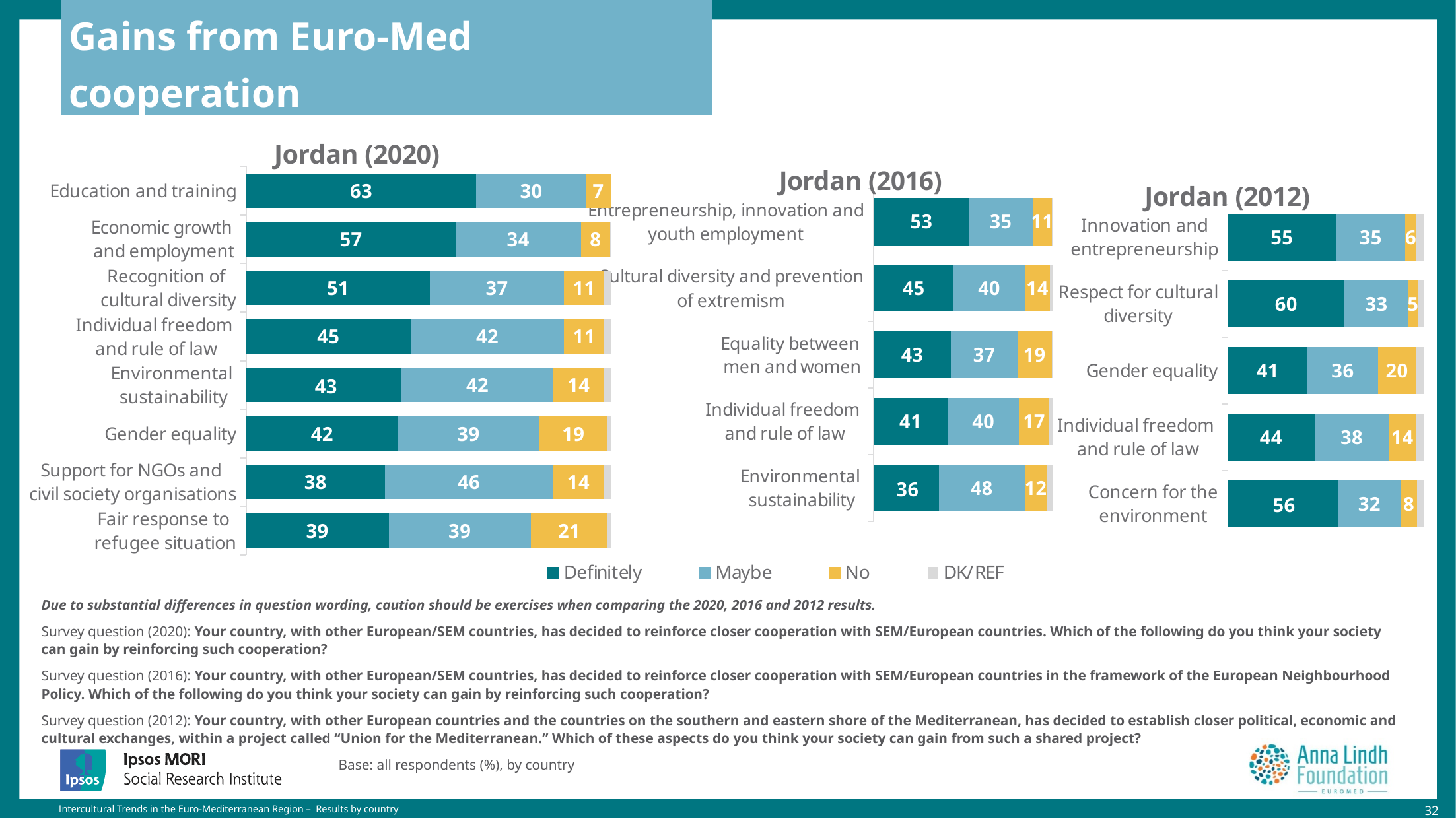
How many series does the legend list? 4 In the Jordan (2012) chart, what is the 'No' value for Gender equality? 20 In the Jordan (2020) chart, what is the difference between the 'Definitely' values for Education and training and Economic growth and employment? 6 In the Jordan (2020) chart, what is the 'No' value for Fair response to refugee situation? 21 How many categories are shown in the Jordan (2020) chart? 8 In the Jordan (2012) chart, which category has the highest 'Definitely' value? Respect for cultural diversity In the Jordan (2016) chart, which category has the lowest 'Definitely' value? Environmental sustainability In the Jordan (2016) chart, which has the larger 'Definitely' value: Entrepreneurship, innovation and youth employment or Cultural diversity and prevention of extremism? Entrepreneurship, innovation and youth employment In the Jordan (2020) chart, which category has the highest 'Definitely' value? Education and training In the Jordan (2016) chart, what is the 'Maybe' value for Environmental sustainability? 48 What kind of chart is the Jordan (2012) chart? Stacked bar chart In the Jordan (2020) chart, what is the 'Definitely' value for Education and training? 63